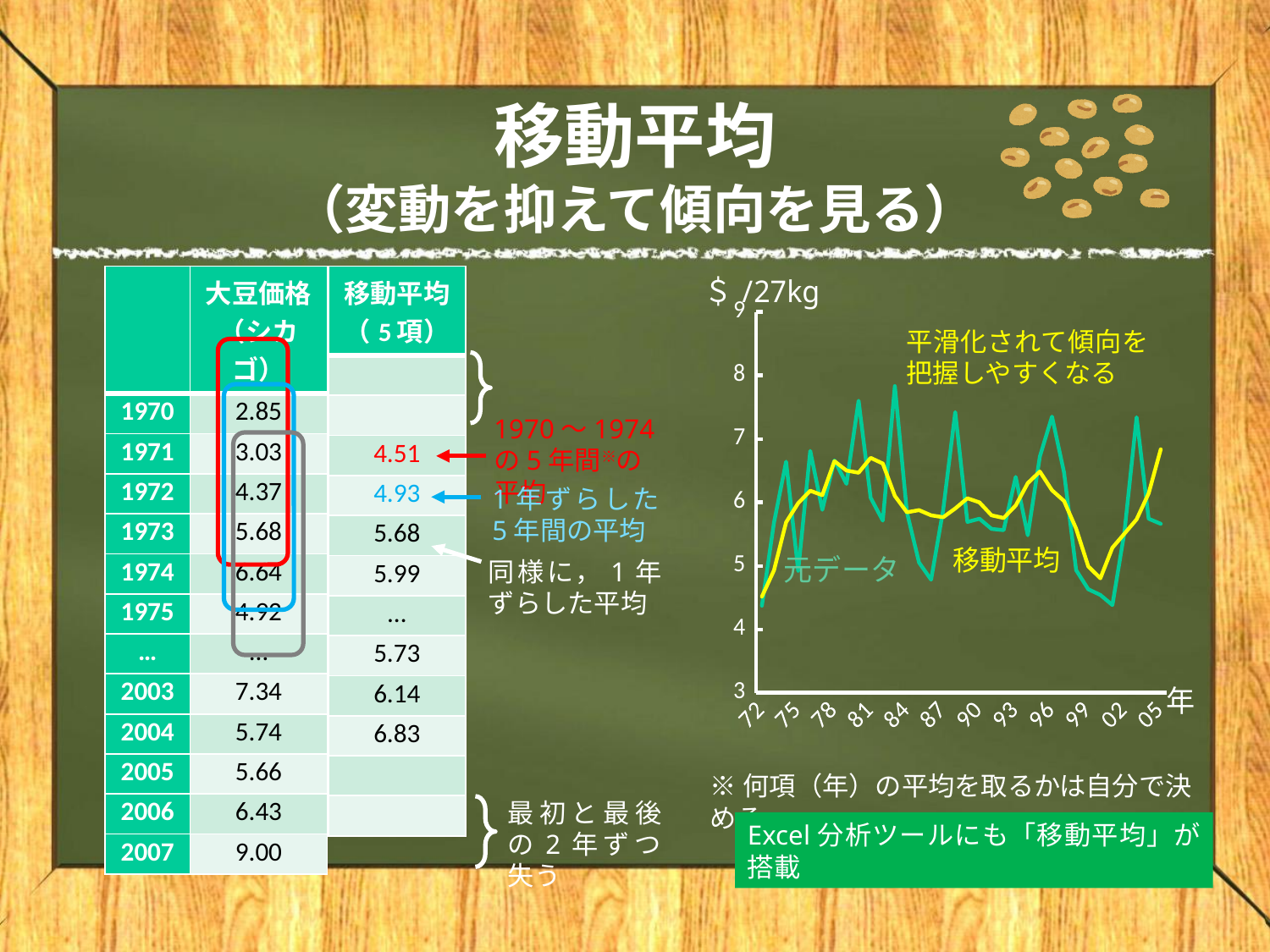
What colour is the 移動平均 line in the chart? yellow What unit is shown on the y axis of the line chart? $/27kg How many series are plotted in the line chart? 2 Is the 移動平均 value at 05 greater or less than 6? greater What kind of chart is shown on the right side of the slide? line chart How many year labels are shown on the x axis of the line chart? 12